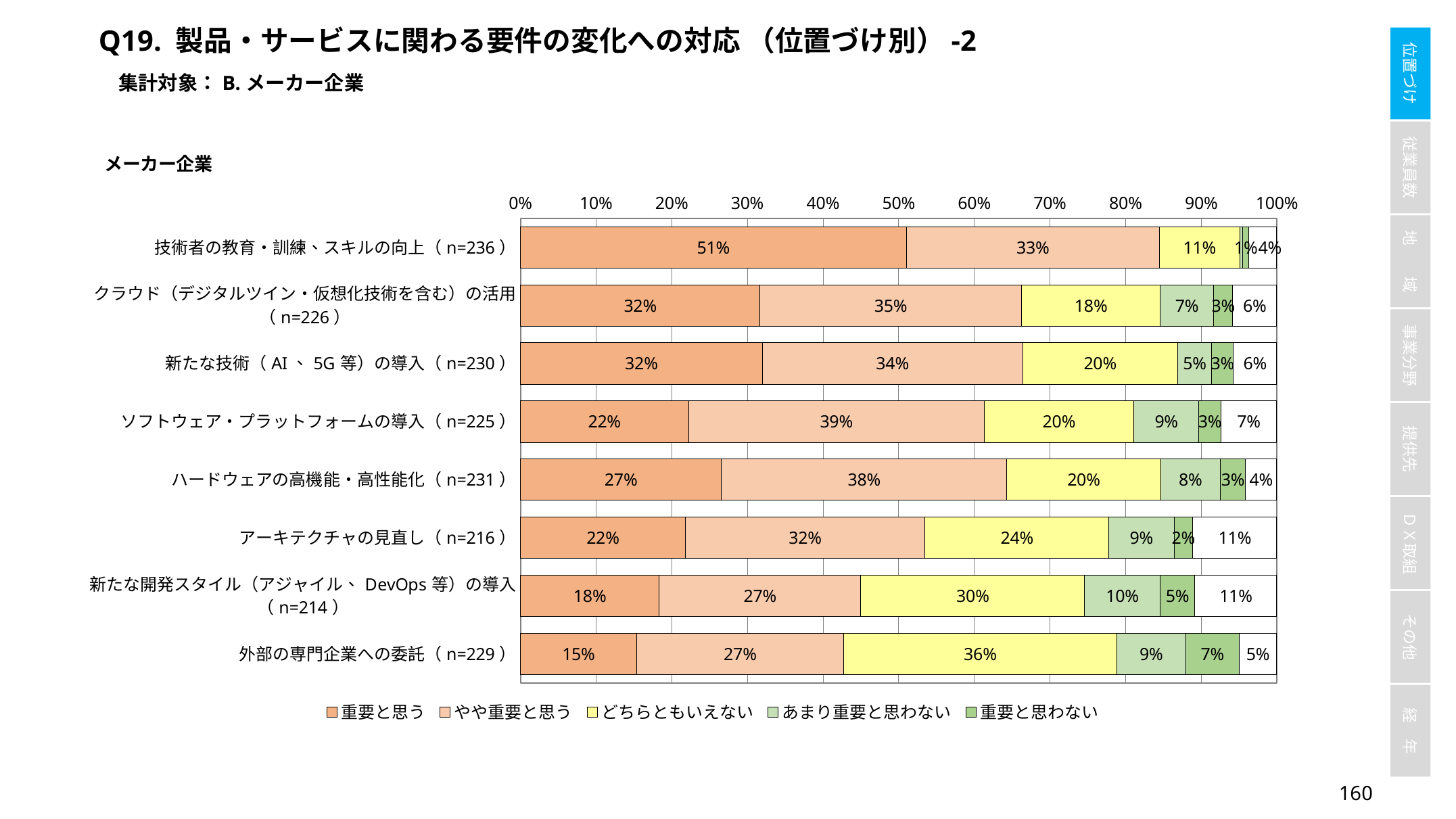
What is the first series listed in the legend? 重要と思う How many categories (rows) are plotted in the chart? 8 How many series does the legend list? 5 What is the やや重要と思う value for ソフトウェア・プラットフォームの導入（n=225）? 39% What is the 重要と思う value for 技術者の教育・訓練、スキルの向上（n=236）? 51% What is the どちらともいえない value for 外部の専門企業への委託（n=229）? 36% Which category has the highest 重要と思う value? 技術者の教育・訓練、スキルの向上（n=236） What is the difference between the 重要と思う values for 技術者の教育・訓練、スキルの向上（n=236） and クラウド（デジタルツイン・仮想化技術を含む）の活用（n=226）? 19% Which has the larger どちらともいえない value: アーキテクチャの見直し（n=216） or 新たな開発スタイル（アジャイル、DevOps等）の導入（n=214）? 新たな開発スタイル（アジャイル、DevOps等）の導入（n=214） What kind of chart is shown on the slide? Stacked bar chart Which category has the lowest 重要と思う value? 外部の専門企業への委託（n=229） What is the 重要と思わない value for 外部の専門企業への委託（n=229）? 7%